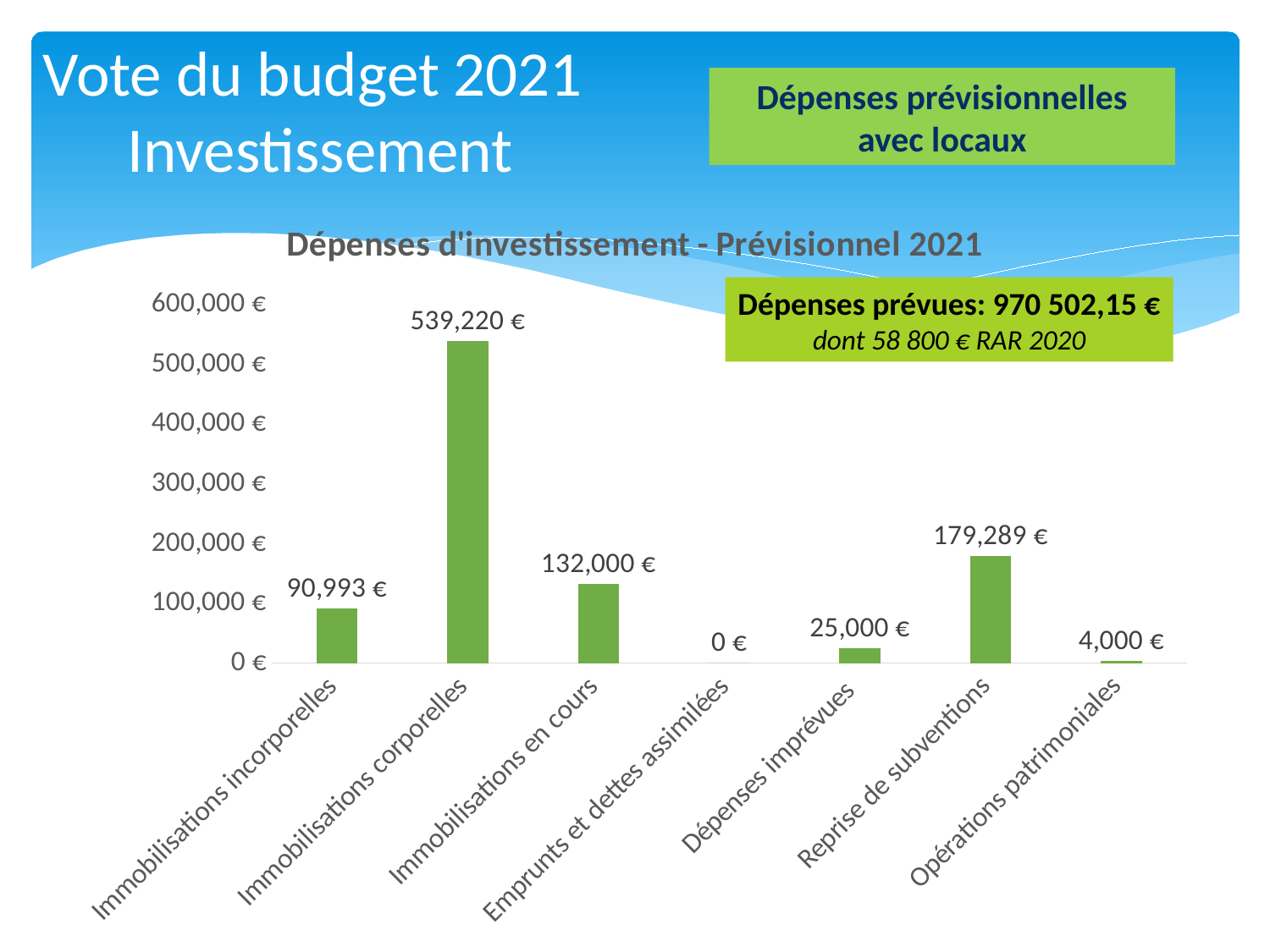
What is the difference between Immobilisations corporelles and Reprise de subventions? 359,931 € Which category has the highest value? Immobilisations corporelles What is the value for Emprunts et dettes assimilées? 0 € What is the value for Immobilisations incorporelles? 90,993 € What kind of chart is shown? Bar chart Which is larger, Immobilisations en cours or Immobilisations incorporelles? Immobilisations en cours What is the title of the chart? Dépenses d'investissement - Prévisionnel 2021 Which category has the lowest value? Emprunts et dettes assimilées What is the value for Immobilisations corporelles? 539,220 € How many categories are shown on the x axis? 7 What is the value for Reprise de subventions? 179,289 € What is the difference between Dépenses imprévues and Opérations patrimoniales? 21,000 €